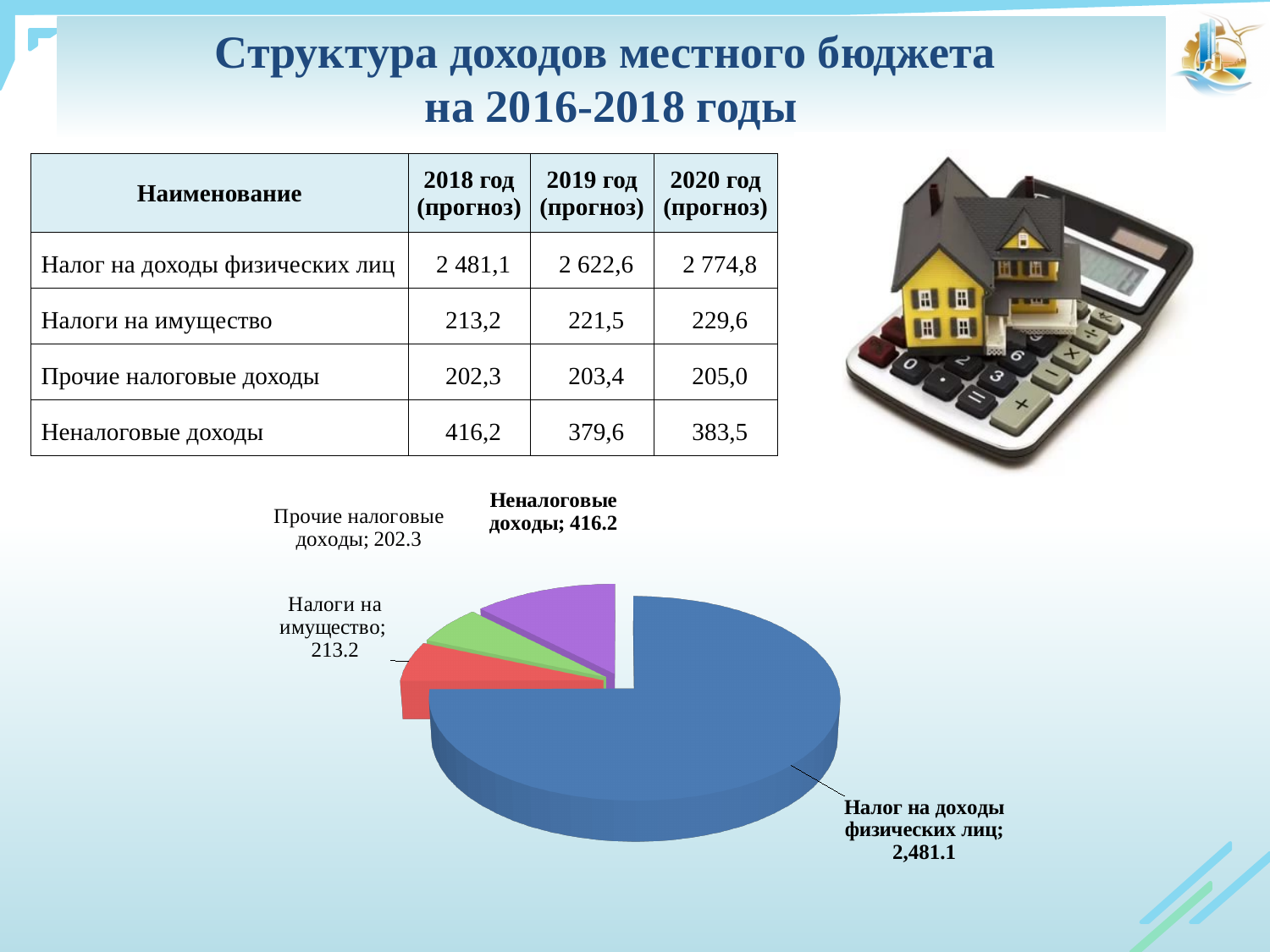
What is the difference between the values for Налог на доходы физических лиц and Неналоговые доходы in the pie chart? 2,064.9 Which is larger in the pie chart: Неналоговые доходы or Налоги на имущество? Неналоговые доходы How many slices does the pie chart have? 4 What value is shown for Неналоговые доходы in the pie chart? 416.2 What is the difference between the values for Неналоговые доходы and Налоги на имущество in the pie chart? 203.0 What type of chart is shown on the slide? Pie chart What colour is the slice for Налог на доходы физических лиц in the pie chart? Blue What value is shown for Прочие налоговые доходы in the pie chart? 202.3 Which category has the smallest slice in the pie chart? Прочие налоговые доходы What value is shown for Налог на доходы физических лиц in the pie chart? 2,481.1 Which category has the largest slice in the pie chart? Налог на доходы физических лиц What value is shown for Налоги на имущество in the pie chart? 213.2